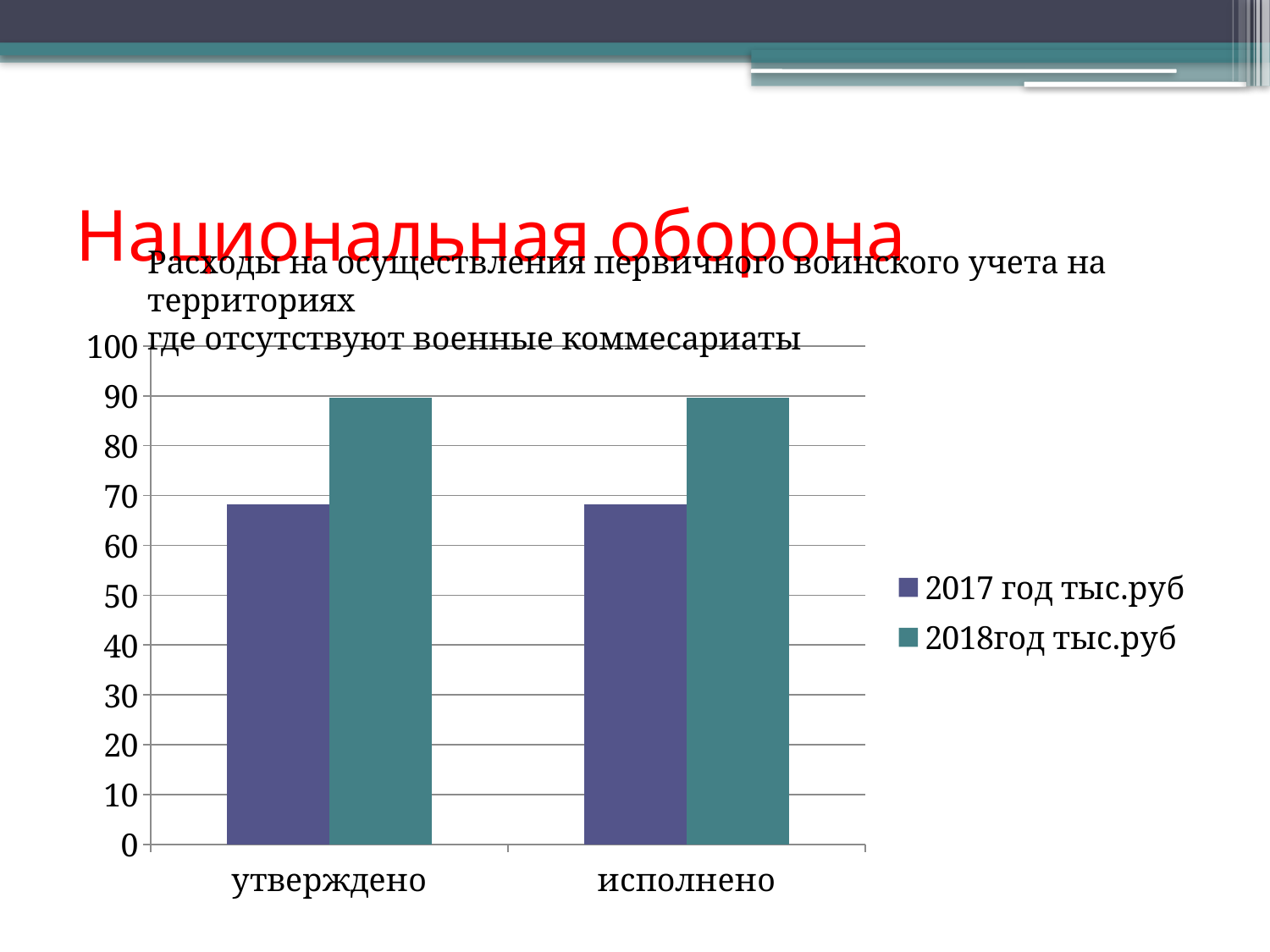
Which series is larger for the category 'исполнено': '2017 год тыс.руб' or '2018год тыс.руб'? 2018год тыс.руб How many categories are shown on the x axis of the chart? 2 Is the value for '2017 год тыс.руб' in the category 'утверждено' greater or less than 60? greater What kind of chart is shown on the slide? bar chart Which series is larger for the category 'утверждено': '2017 год тыс.руб' or '2018год тыс.руб'? 2018год тыс.руб What is the highest value shown on the y axis of the chart? 100 Is the value for '2017 год тыс.руб' in the category 'исполнено' greater or less than 70? less What are the two category labels on the x axis of the chart? утверждено, исполнено Is the value for '2018год тыс.руб' in the category 'утверждено' greater or less than 80? greater What is the second entry in the chart legend? 2018год тыс.руб How many series does the chart legend list? 2